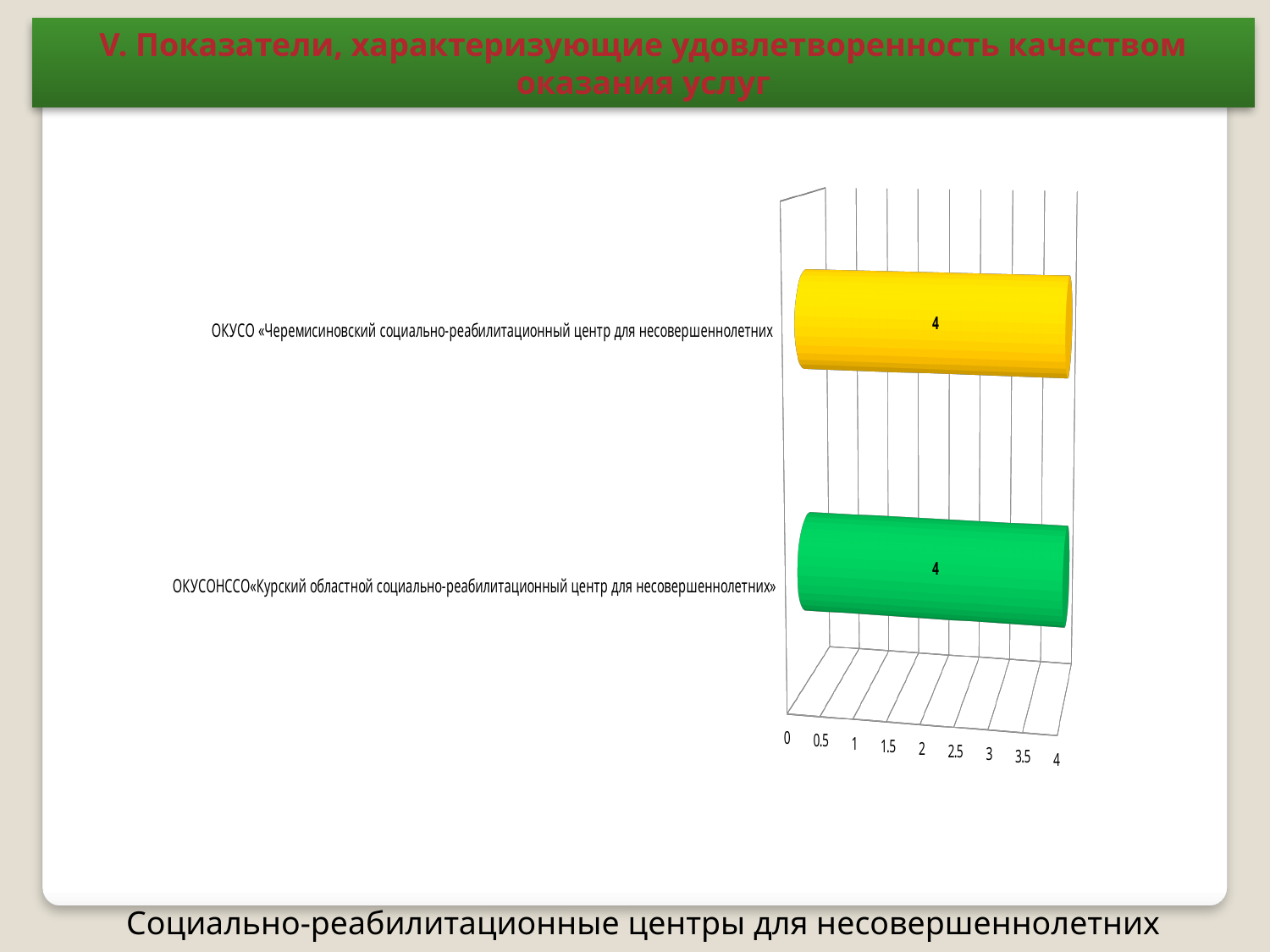
What is the maximum value shown on the horizontal axis? 4 Is the value for the Курский областной centre greater or less than 2? greater What colour is the bar for the Черемисиновский centre? Yellow What is the value for ОКУСО «Черемисиновский социально-реабилитационный центр для несовершеннолетних»? 4 How many categories are plotted in the chart? 2 What kind of chart is shown on the slide? Bar chart Is the value for the Черемисиновский centre greater or less than 3? greater Which has the larger value, the Черемисиновский centre or the Курский областной centre? They are equal What is the value for ОКУСОНССО «Курский областной социально-реабилитационный центр для несовершеннолетних»? 4 What is the difference between the values for the Черемисиновский centre and the Курский областной centre? 0